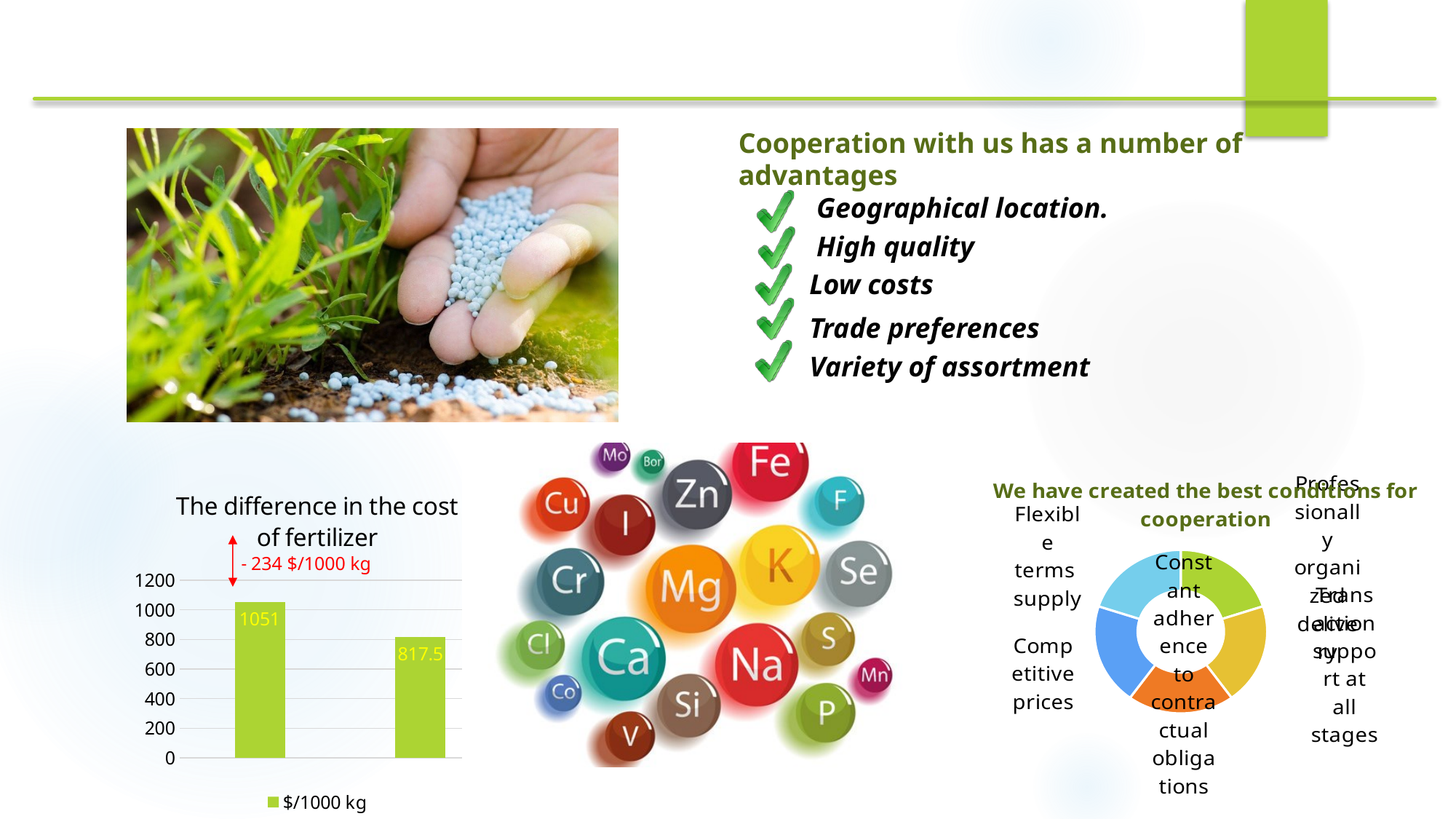
In 'The difference in the cost of fertilizer' chart, what is the value of the right bar? 817.5 What type of chart is 'We have created the best conditions for cooperation'? doughnut chart What type of chart is 'The difference in the cost of fertilizer'? bar chart How many segments does the 'We have created the best conditions for cooperation' chart have? 5 In 'The difference in the cost of fertilizer' chart, which bar is higher, the left or the right? left What difference in cost is annotated with the red arrow on 'The difference in the cost of fertilizer' chart? - 234 $/1000 kg In 'The difference in the cost of fertilizer' chart, is the value of the left bar greater or less than 1000? greater How many series does the legend of 'The difference in the cost of fertilizer' chart list? 1 What is the legend entry in 'The difference in the cost of fertilizer' chart? $/1000 kg In 'The difference in the cost of fertilizer' chart, what is the value of the left bar? 1051 Do the values in 'The difference in the cost of fertilizer' chart rise or fall from left to right? fall How many bars are plotted in 'The difference in the cost of fertilizer' chart? 2